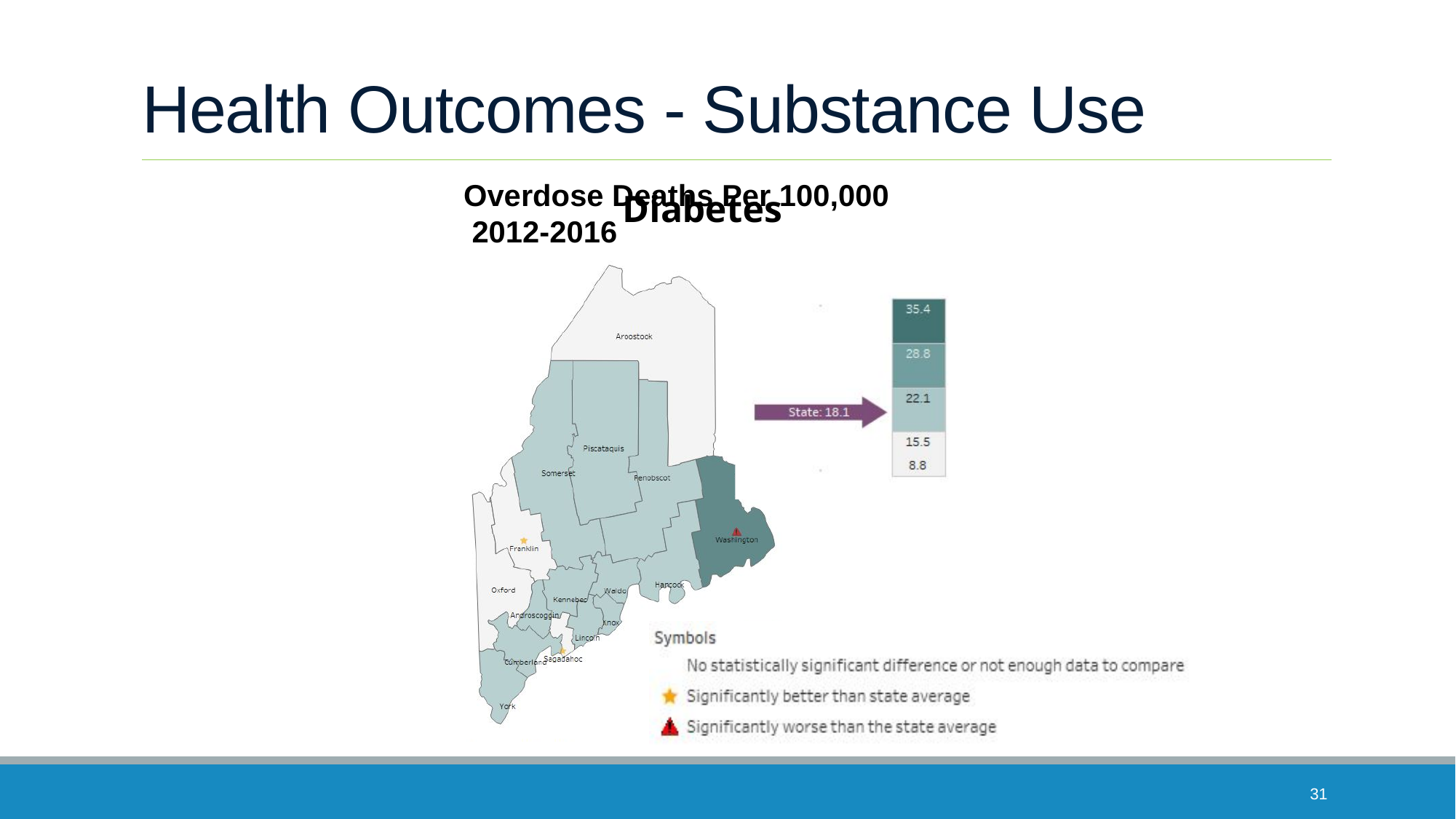
What does the star symbol mean in the map's symbol key? Significantly better than state average How many values are labelled on the colour legend of the map? 5 What is the lowest value shown on the colour legend of the map? 8.8 What kind of chart is shown on the slide? A map (choropleth map of Maine counties) What is the difference between the highest and lowest values on the map's colour legend? 26.6 Is the state value of 18.1 greater or less than the legend value 22.1? less What is the state value shown by the arrow on the map? State: 18.1 Which county on the map is marked with a red triangle as significantly worse than the state average? Washington Which counties on the map are marked with a star as significantly better than the state average? Franklin and Sagadahoc Which county is shaded with the darkest colour on the map? Washington What is the highest value shown on the colour legend of the map? 35.4 What does the red triangle symbol mean in the map's symbol key? Significantly worse than the state average